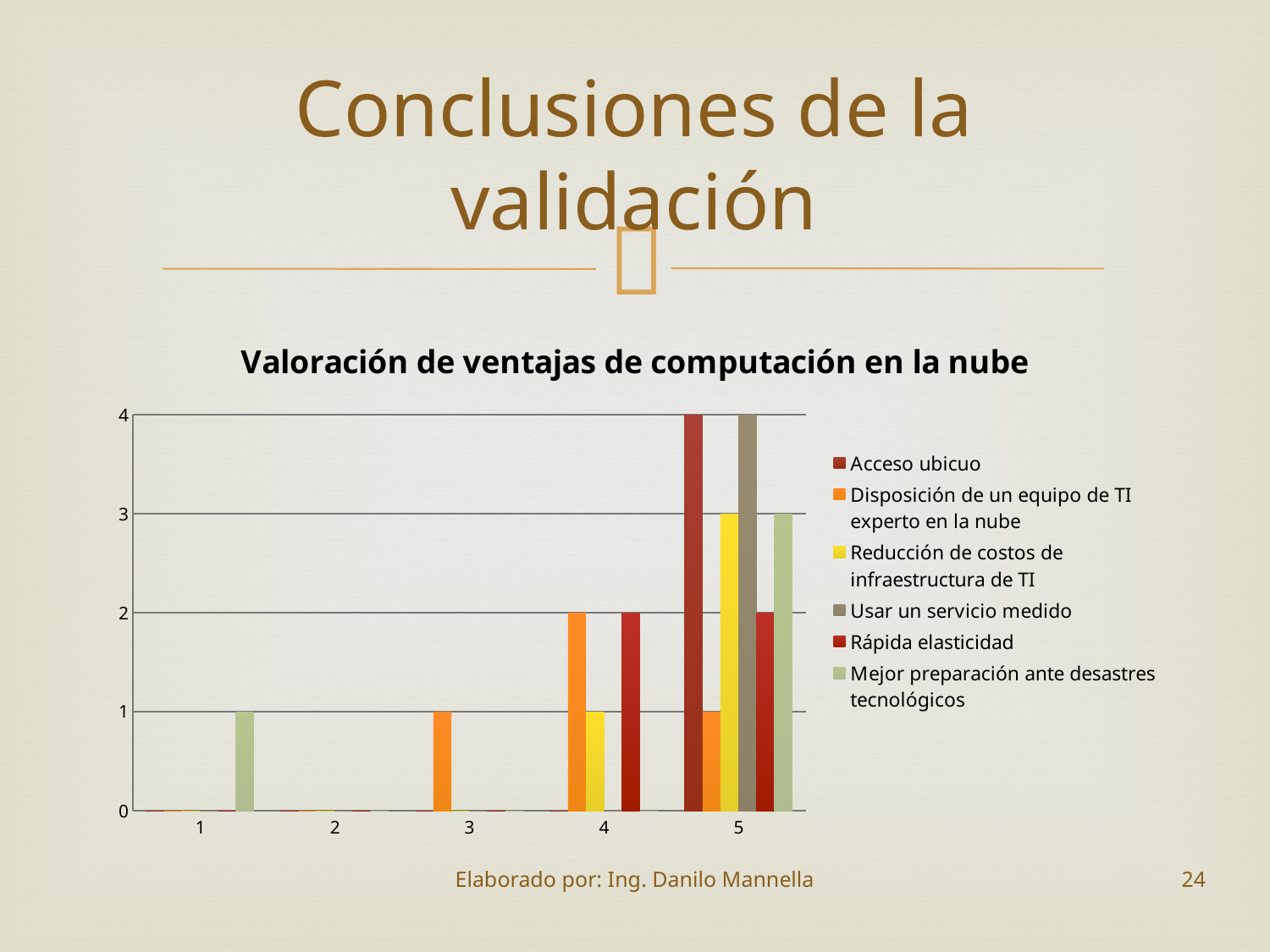
What is the value for Reducción de costos de infraestructura de TI at category 5? 3 What kind of chart is shown on the slide? bar chart At category 5, which is larger: Reducción de costos de infraestructura de TI or Disposición de un equipo de TI experto en la nube? Reducción de costos de infraestructura de TI What is the value for Mejor preparación ante desastres tecnológicos at category 1? 1 What is the difference between Usar un servicio medido and Rápida elasticidad at category 5? 2 How many series does the legend list? 6 How many categories are shown on the x axis? 5 What is the value for Rápida elasticidad at category 5? 2 Which category has the highest value for Disposición de un equipo de TI experto en la nube? 4 What is the value for Acceso ubicuo at category 5? 4 What is the value for Disposición de un equipo de TI experto en la nube at category 4? 2 What is the title of the chart? Valoración de ventajas de computación en la nube